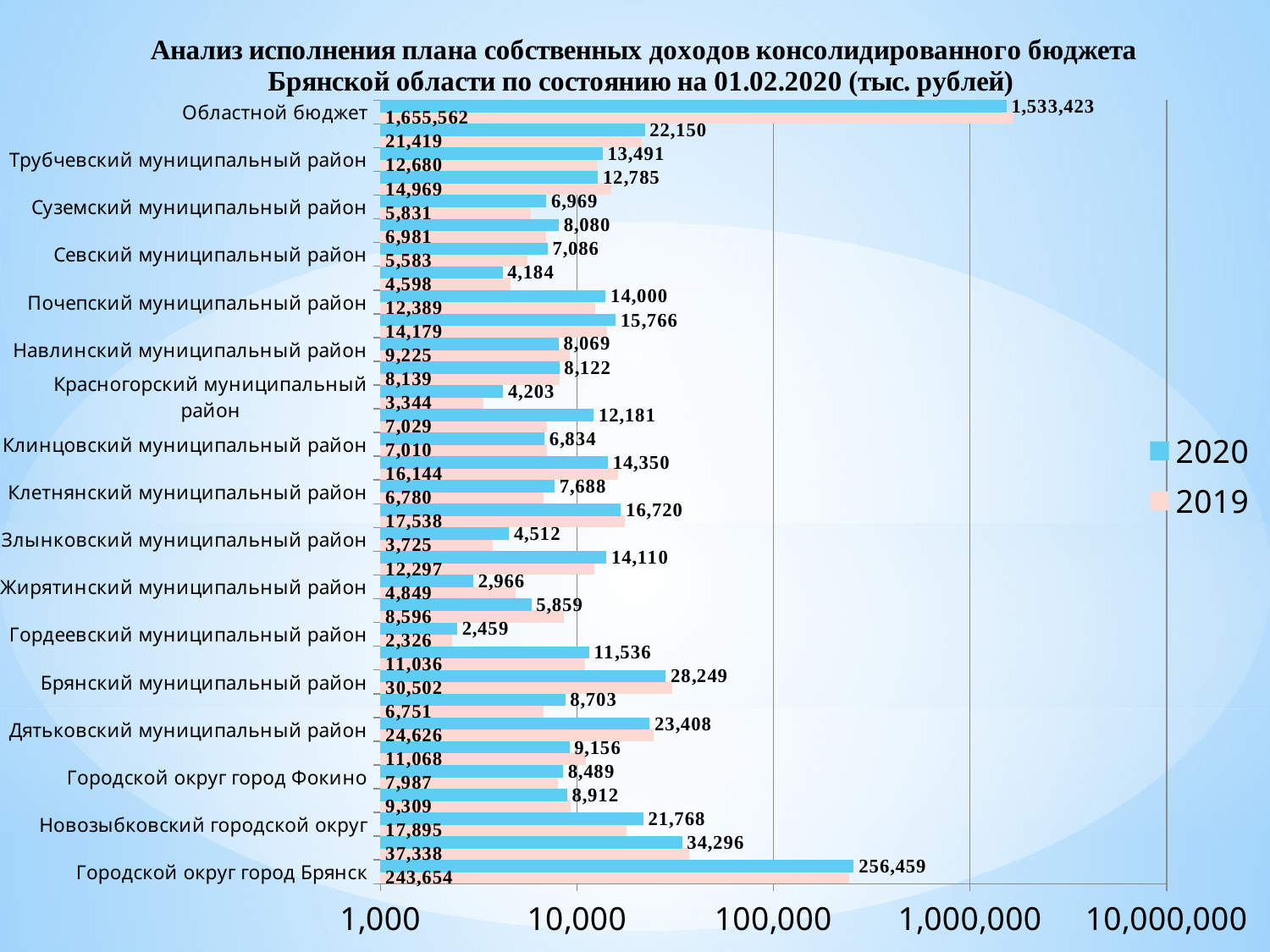
What is the 2020 value for Новозыбковский городской округ? 21,768 What is the difference between the 2020 and 2019 values for Городской округ город Брянск? 12,805 For Жирятинский муниципальный район, which is larger: the 2020 value or the 2019 value? 2019 What is the 2019 value for Областной бюджет? 1,655,562 What is the 2020 value for Городской округ город Брянск? 256,459 Is the 2020 value for Дятьковский муниципальный район greater or less than 10,000? greater What are the two series named in the legend? 2020 and 2019 Which category has the highest 2020 value? Областной бюджет What is the 2020 value for Областной бюджет? 1,533,423 How many series does the legend list? 2 What is the 2019 value for Брянский муниципальный район? 30,502 What type of chart is shown on the slide? bar chart